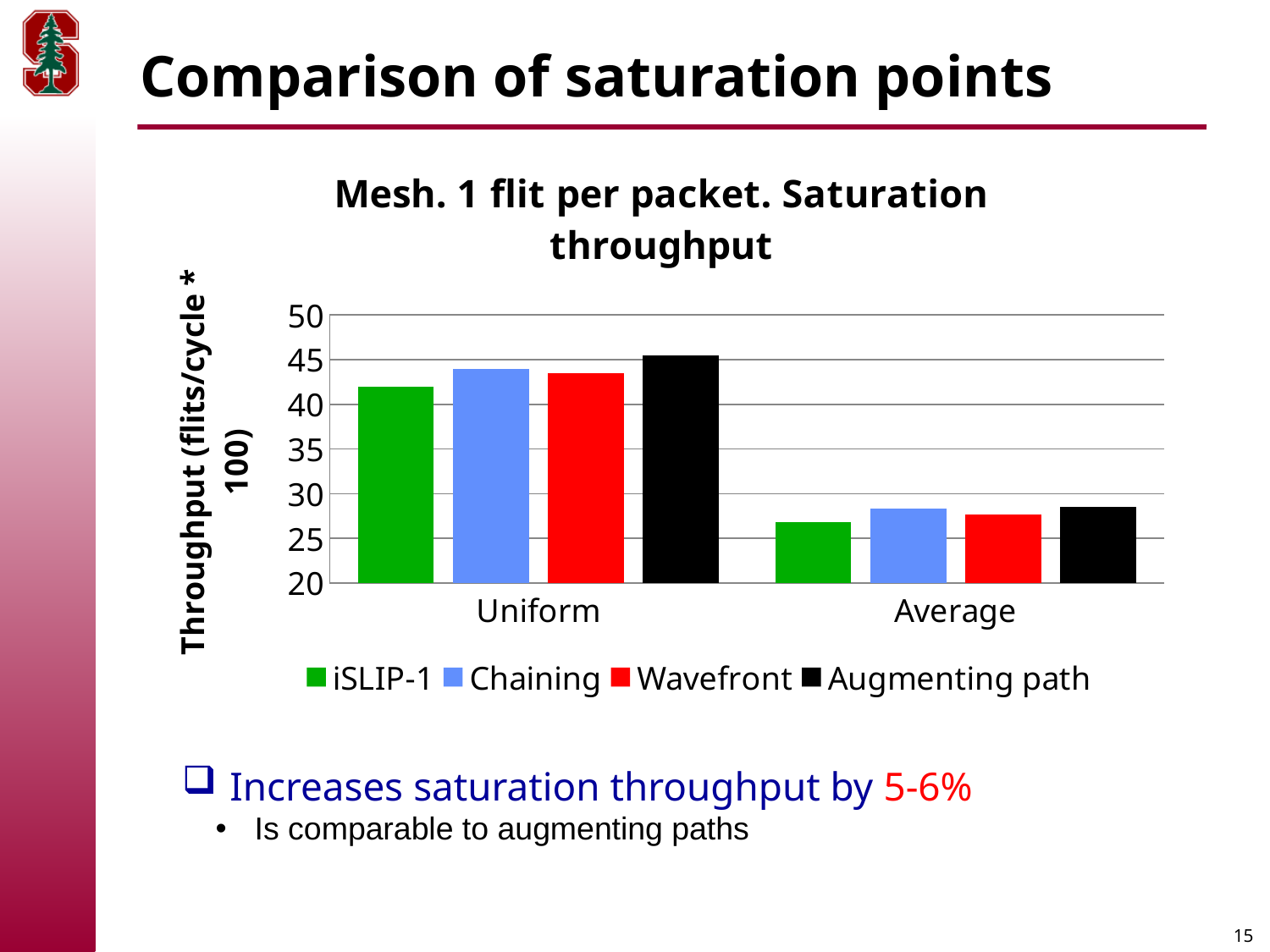
How many categories are shown on the x axis? 2 Is the value for Chaining in the Average category greater or less than 30? less Is the value for iSLIP-1 in the Uniform category greater or less than 40? greater What is the label of the y axis? Throughput (flits/cycle * 100) Which series has the highest value in the Uniform category? Augmenting path How many series does the legend list? 4 In the Uniform category, which is larger: iSLIP-1 or Augmenting path? Augmenting path In the Average category, which is larger: iSLIP-1 or Chaining? Chaining Which series has the lowest value in the Average category? iSLIP-1 What kind of chart is shown on the slide? bar chart Which series has the lowest value in the Uniform category? iSLIP-1 Do the values for each series rise or fall from Uniform to Average? fall